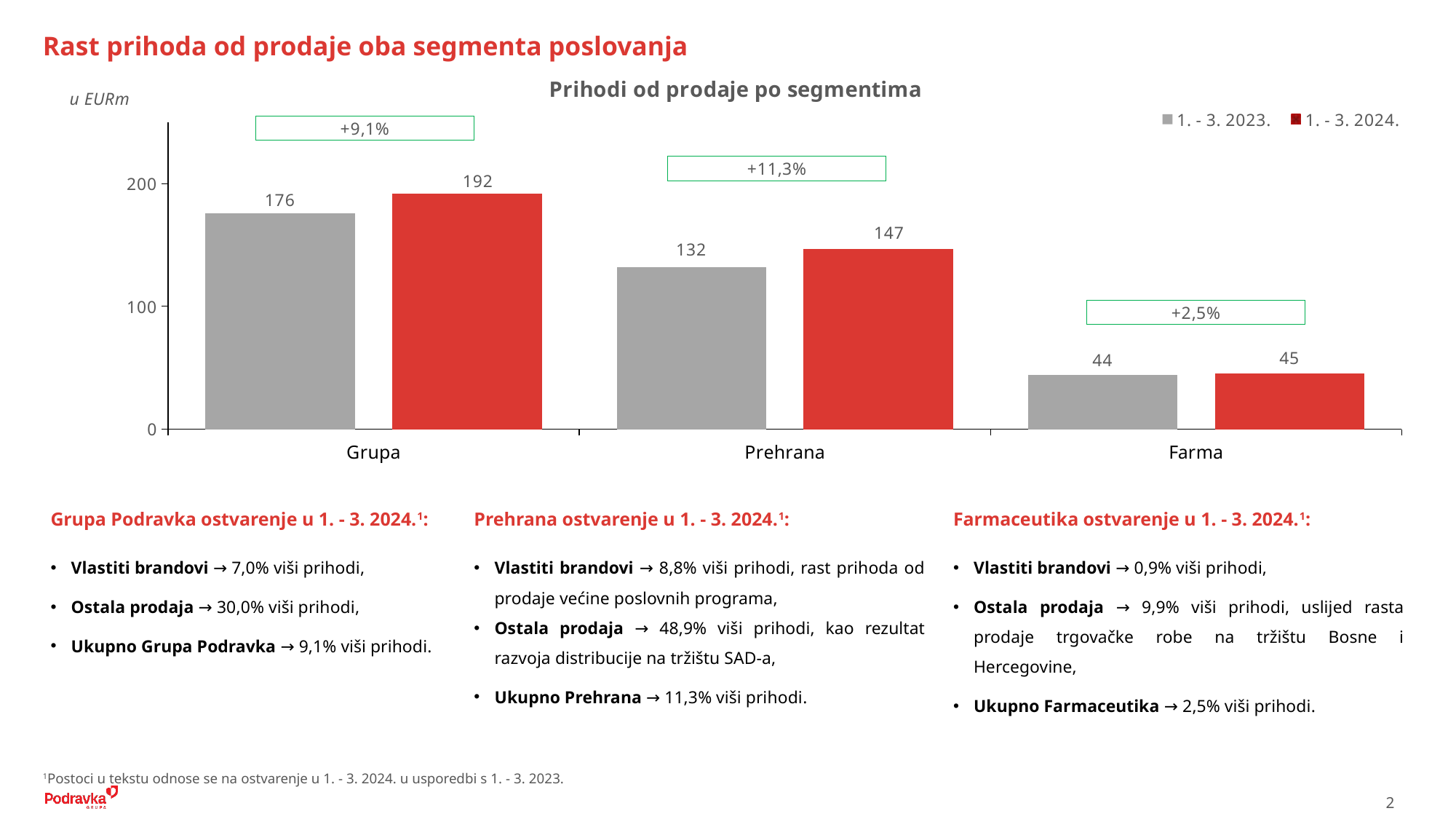
What is the value for Prehrana in the 1. - 3. 2023. series? 132 How many categories are shown on the x axis? 3 What type of chart is shown? bar chart Which category has the highest value in the 1. - 3. 2024. series? Grupa Is the value for Prehrana in 1. - 3. 2023. greater or less than 100? greater Which is larger for Prehrana: the 1. - 3. 2023. value or the 1. - 3. 2024. value? 1. - 3. 2024. What is the difference between the 1. - 3. 2024. and 1. - 3. 2023. values for Grupa? 16 How many series does the legend list? 2 What is the value for Farma in the 1. - 3. 2024. series? 45 Which category has the lowest value in the 1. - 3. 2023. series? Farma What is the difference between the 1. - 3. 2024. and 1. - 3. 2023. values for Prehrana? 15 What is the value for Grupa in the 1. - 3. 2024. series? 192